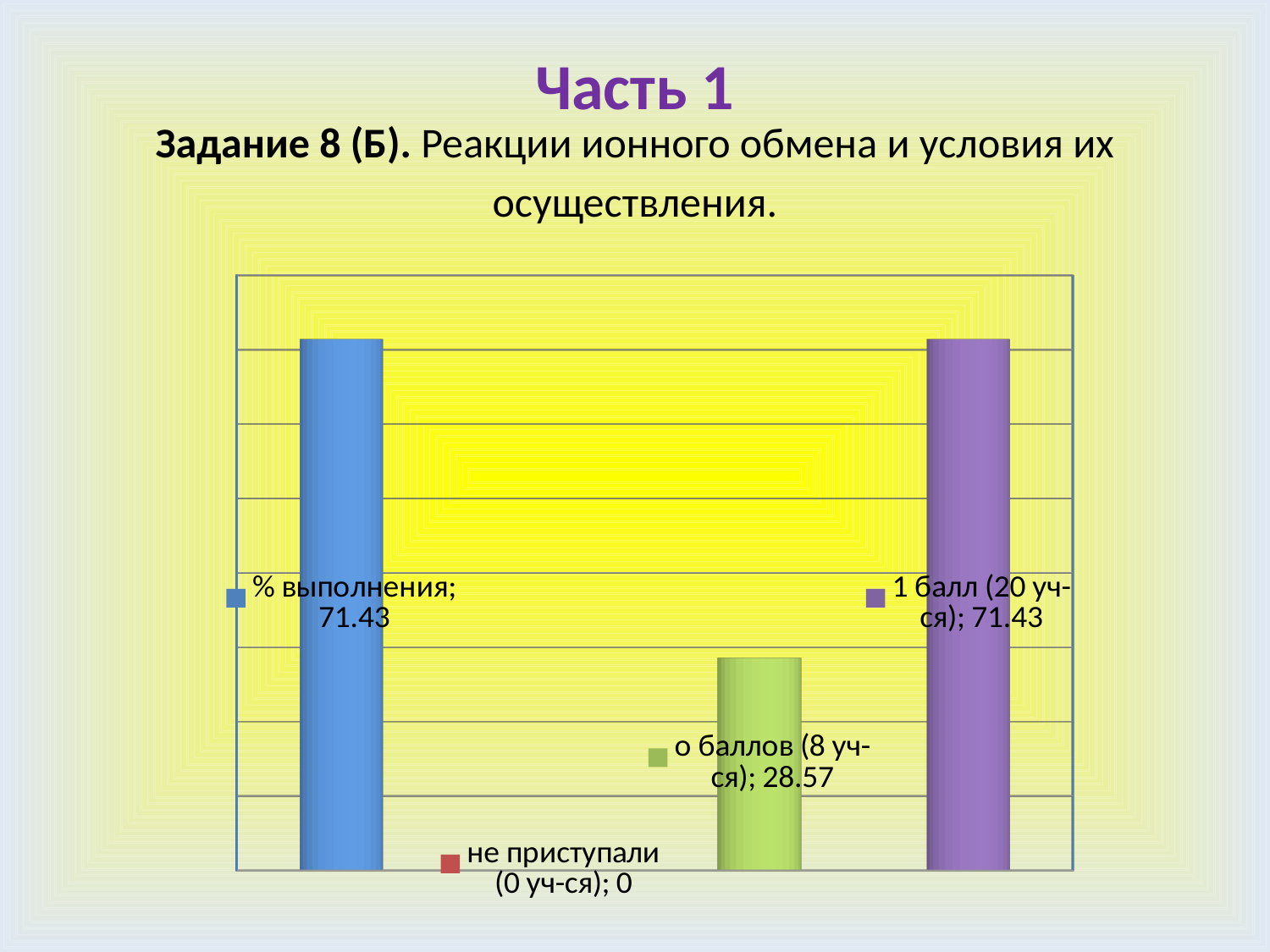
What is the value shown for "% выполнения"? 71.43 What is the difference between the values for "1 балл (20 уч-ся)" and "о баллов (8 уч-ся)"? 42.86 How many bars (categories) are shown in the chart? 4 What is the value shown for "1 балл (20 уч-ся)"? 71.43 Which category has the lowest value? не приступали (0 уч-ся) What is the value shown for "не приступали (0 уч-ся)"? 0 Which is larger: the value for "о баллов (8 уч-ся)" or the value for "не приступали (0 уч-ся)"? о баллов (8 уч-ся) What kind of chart is shown on the slide? bar chart What colour is the bar for "1 балл (20 уч-ся)"? purple What colour is the bar for "% выполнения"? blue What is the value shown for "о баллов (8 уч-ся)"? 28.57 Which is larger: the value for "1 балл (20 уч-ся)" or the value for "о баллов (8 уч-ся)"? 1 балл (20 уч-ся)